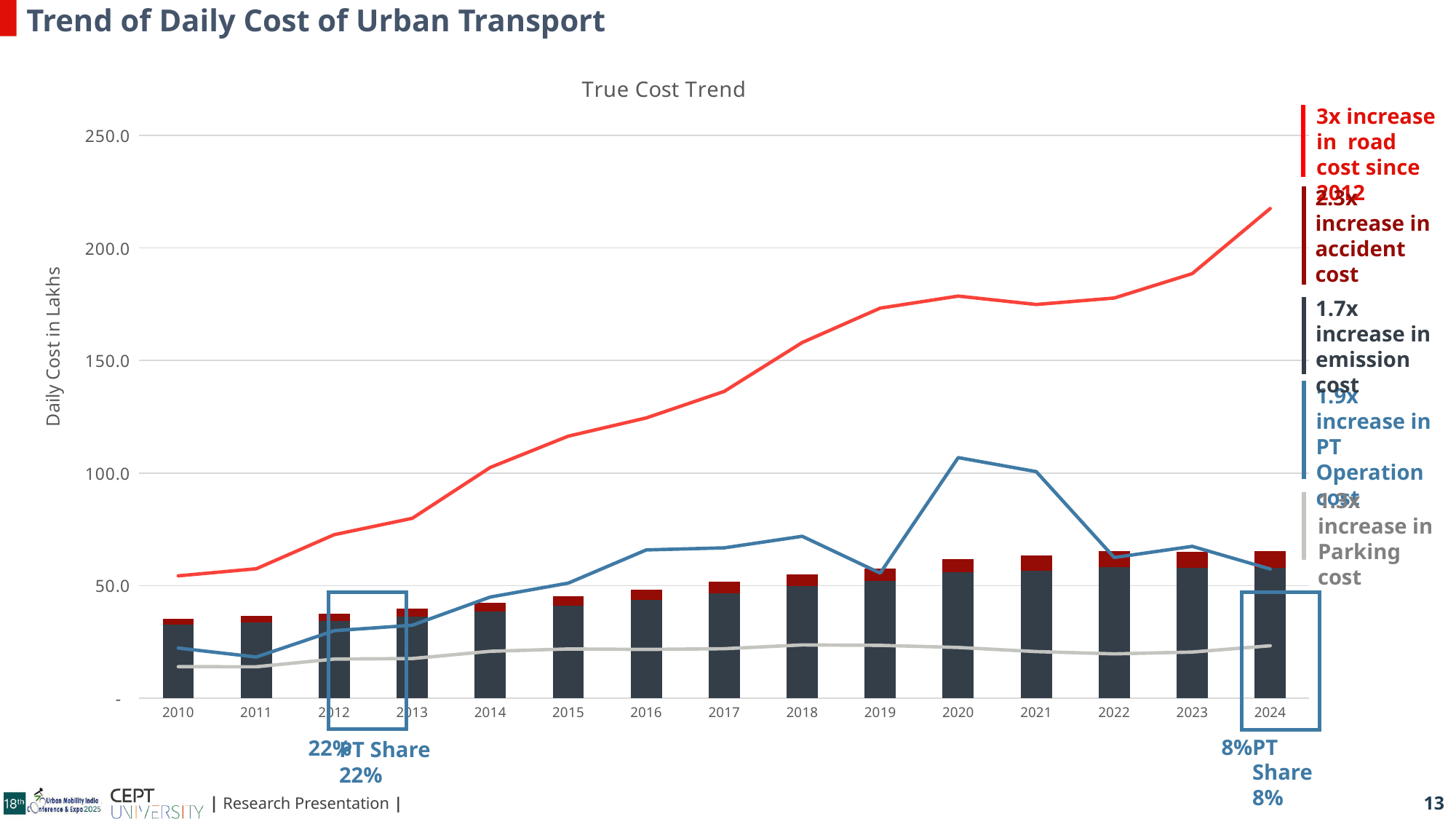
Is the total height of the stacked bar for 2010 greater or less than 50? less In which year does the red line reach its highest value? 2024 Is the value of the red line in 2024 greater or less than 200? greater In which year is the red line at its lowest value? 2010 Is the value of the red line in 2010 greater or less than 100? less What is the label of the vertical axis? Daily Cost in Lakhs In 2024, which is larger: the red line or the blue line? red line Does the red line generally rise or fall from 2010 to 2024? rise What kind of chart is the True Cost Trend chart? Combination bar and line chart What is the title of the chart on the slide? True Cost Trend How many years are shown on the x axis of the True Cost Trend chart? 15